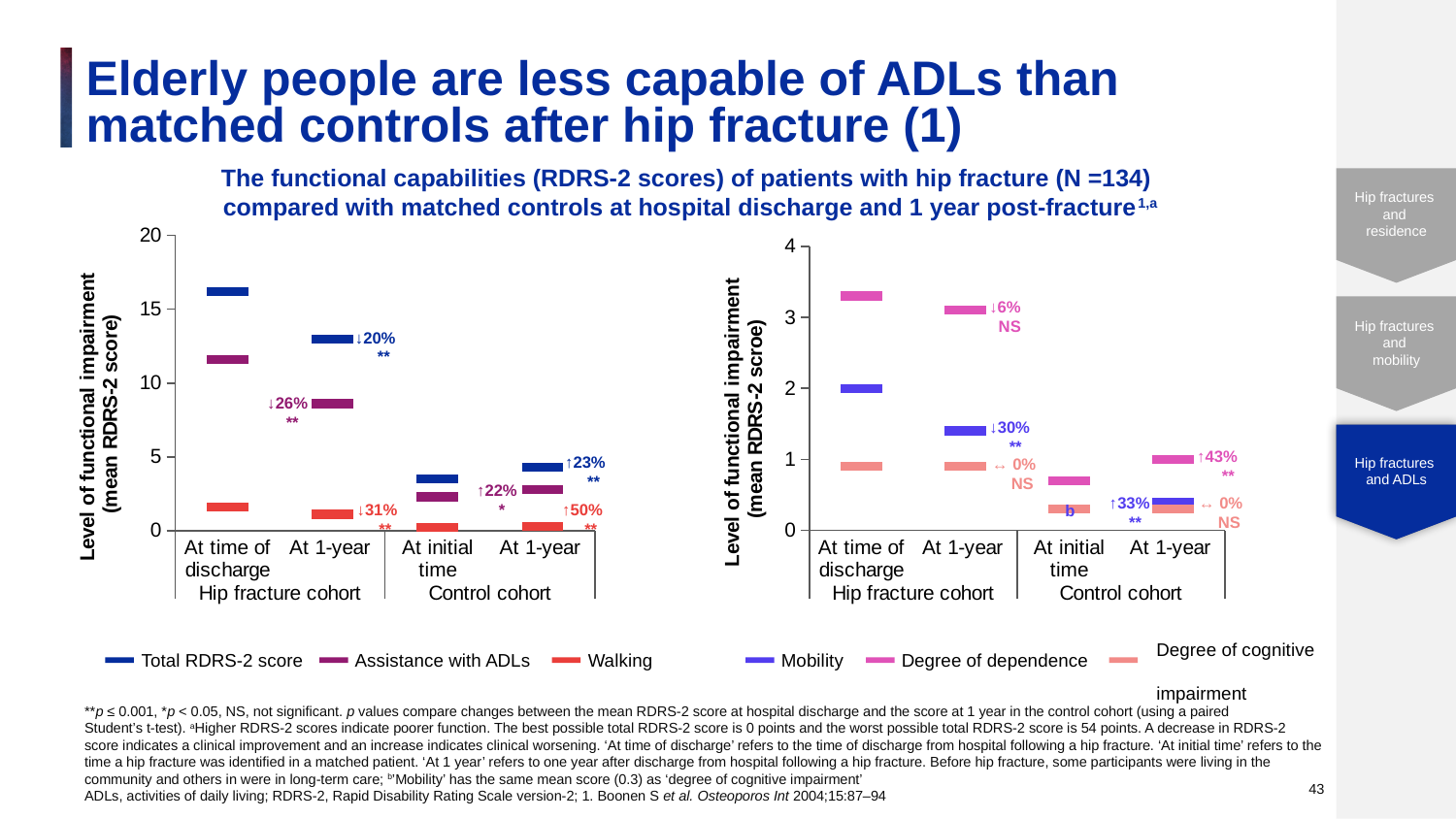
On the right chart, how many series does the legend list? 3 On the left chart, how many series does the legend list? 3 On the left chart, what percentage change is labelled for Walking at 1-year in the control cohort? ↑50% On the left chart, which series has the highest value at time of discharge in the hip fracture cohort? Total RDRS-2 score On the right chart, is the Degree of dependence score at time of discharge in the hip fracture cohort greater or less than 3? greater On the left chart, is the Walking score at time of discharge in the hip fracture cohort greater or less than 5? less On the left chart, what percentage change is labelled for the Total RDRS-2 score at 1-year in the hip fracture cohort? ↓20% On the right chart, what percentage change is labelled for Degree of dependence at 1-year in the control cohort? ↑43% On the left chart, is the Total RDRS-2 score at initial time in the control cohort greater or less than 5? less On the right chart, what percentage change is labelled for Mobility at 1-year in the hip fracture cohort? ↓30% On the right chart, at time of discharge in the hip fracture cohort, which is larger: Degree of dependence or Mobility? Degree of dependence